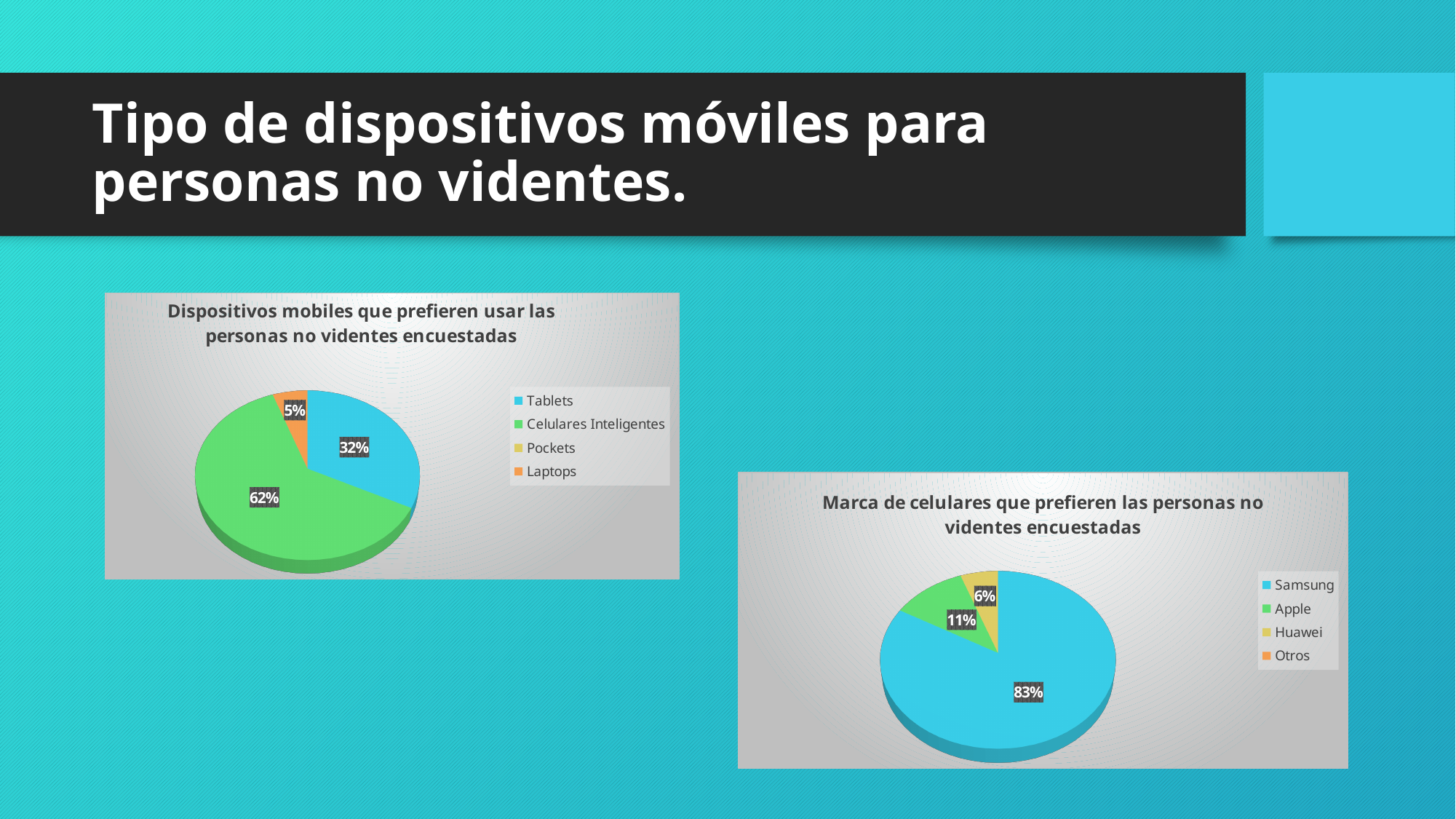
In the right chart, 'Marca de celulares que prefieren las personas no videntes encuestadas', which brand has the largest slice? Samsung In the right chart, 'Marca de celulares que prefieren las personas no videntes encuestadas', what percentage is shown for Samsung? 83% In the left chart, 'Dispositivos mobiles que prefieren usar las personas no videntes encuestadas', what percentage is shown for Tablets? 32% In the right chart, 'Marca de celulares que prefieren las personas no videntes encuestadas', what percentage is shown for Huawei? 6% In the left chart, 'Dispositivos mobiles que prefieren usar las personas no videntes encuestadas', how many categories does the legend list? 4 In the left chart, 'Dispositivos mobiles que prefieren usar las personas no videntes encuestadas', what percentage is shown for Laptops? 5% In the right chart, 'Marca de celulares que prefieren las personas no videntes encuestadas', which is larger, Apple or Huawei? Apple In the right chart, 'Marca de celulares que prefieren las personas no videntes encuestadas', what percentage is shown for Apple? 11% In the left chart, 'Dispositivos mobiles que prefieren usar las personas no videntes encuestadas', what percentage is shown for Celulares Inteligentes? 62% In the left chart, 'Dispositivos mobiles que prefieren usar las personas no videntes encuestadas', which category has the largest slice? Celulares Inteligentes In the left chart, 'Dispositivos mobiles que prefieren usar las personas no videntes encuestadas', what is the difference in percentage points between Celulares Inteligentes and Tablets? 30 What type of chart is the right chart, 'Marca de celulares que prefieren las personas no videntes encuestadas'? Pie chart